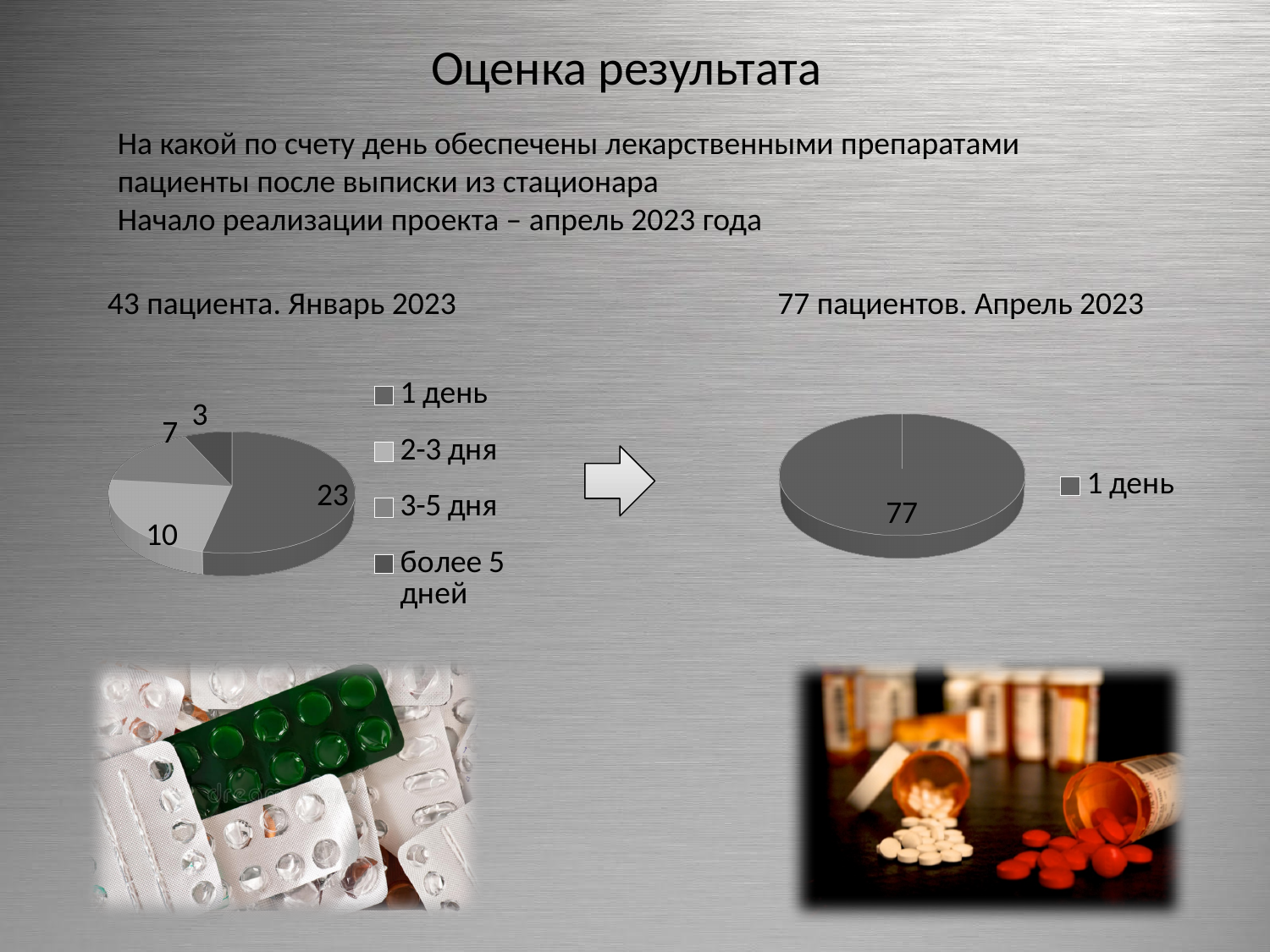
What type of chart is used on the left side of the slide (43 пациента. Январь 2023)? Pie chart In the left pie chart (43 пациента. Январь 2023), which is larger: '3-5 дня' or 'более 5 дней'? 3-5 дня In the left pie chart (43 пациента. Январь 2023), what is the value for the '1 день' slice? 23 In the right pie chart (77 пациентов. Апрель 2023), what is the value for '1 день'? 77 How many slices does the left pie chart (43 пациента. Январь 2023) have? 4 How many entries does the legend of the right pie chart (77 пациентов. Апрель 2023) list? 1 What is the sum of all slice values in the left pie chart (43 пациента. Январь 2023)? 43 In the left pie chart (43 пациента. Январь 2023), what is the difference between the '1 день' and '2-3 дня' values? 13 In the left pie chart (43 пациента. Январь 2023), which category has the largest slice? 1 день In the left pie chart (43 пациента. Январь 2023), which category has the smallest slice? более 5 дней In the left pie chart (43 пациента. Январь 2023), what is the value for the '2-3 дня' slice? 10 In the left pie chart (43 пациента. Январь 2023), what is the value for the 'более 5 дней' slice? 3